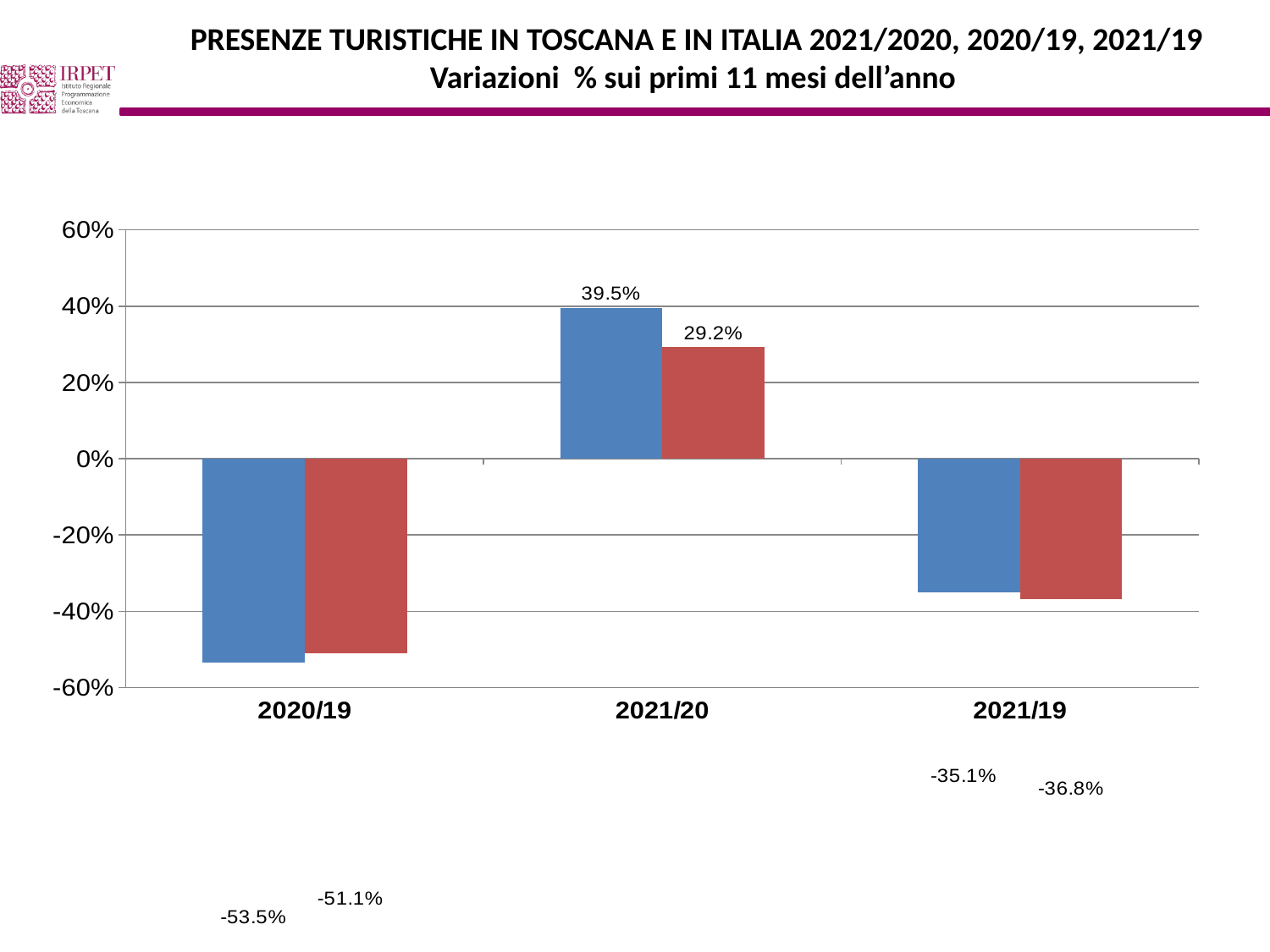
For 2020/19, which is larger, the blue bar or the red bar? the red bar What is the value of the blue bar for 2020/19? -53.5% What is the value of the red bar for 2021/20? 29.2% What is the value of the red bar for 2021/19? -36.8% What kind of chart is shown on the slide? bar chart What is the value of the blue bar for 2021/19? -35.1% How many categories are shown on the x axis? 3 What is the difference between the blue bar and the red bar for 2021/20? 10.3 percentage points What is the value of the blue bar for 2021/20? 39.5% What is the subtitle of the chart on the slide? Variazioni % sui primi 11 mesi dell'anno Which category has the lowest value for the red bars? 2020/19 Which category has the highest value for the blue bars? 2021/20